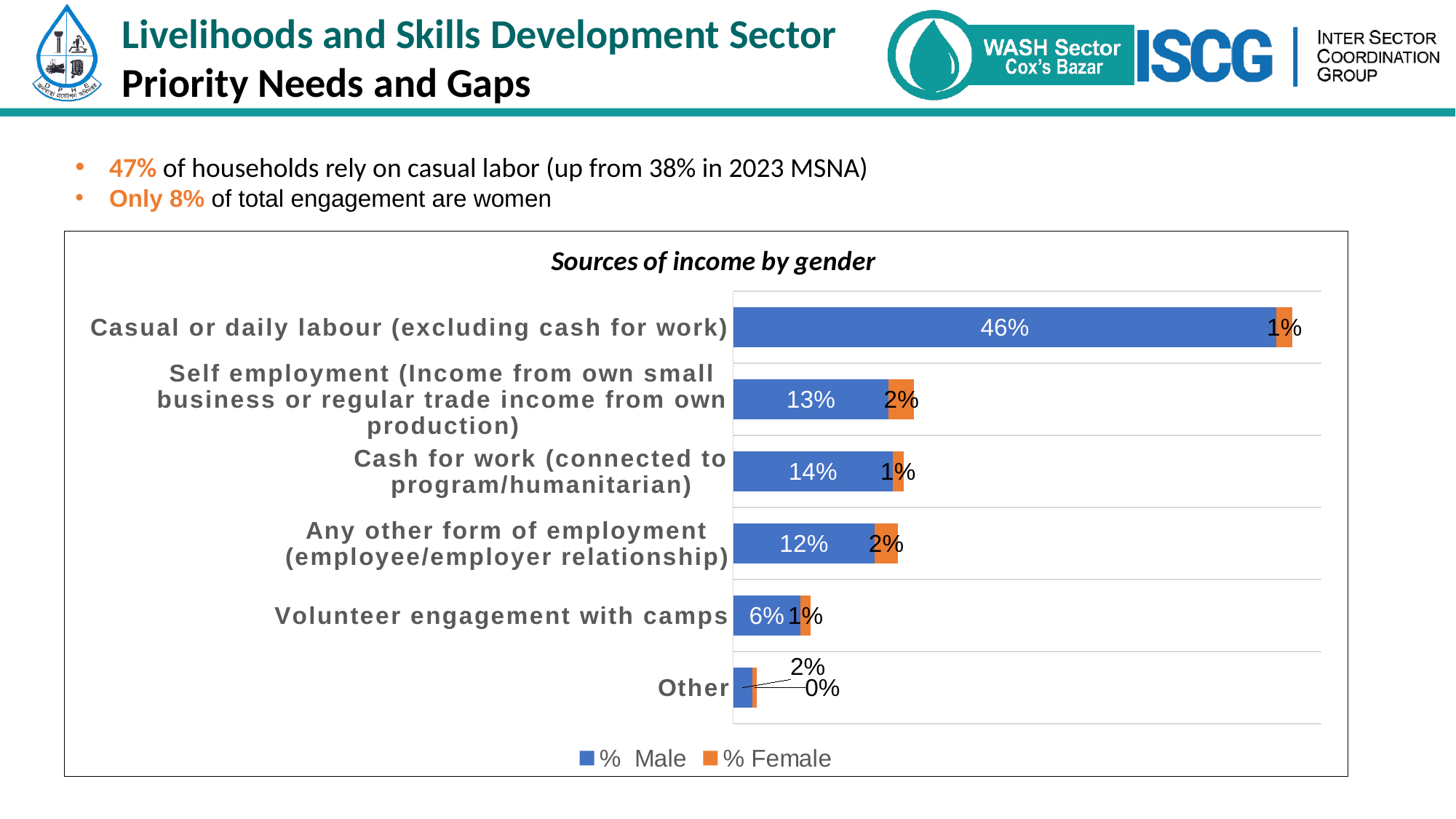
What is the % Male value for Casual or daily labour (excluding cash for work)? 46% Which is larger: the % Male value for Cash for work (connected to program/humanitarian) or for Any other form of employment (employee/employer relationship)? Cash for work (connected to program/humanitarian) What is the % Male value for Cash for work (connected to program/humanitarian)? 14% What is the combined total of % Male and % Female for Volunteer engagement with camps? 7% How many income source categories are shown in the chart? 6 What type of chart is shown on the slide? Stacked bar chart Which category has the lowest % Male value? Other What is the title of the chart? Sources of income by gender What is the % Female value for Self employment (Income from own small business or regular trade income from own production)? 2% What is the difference between the % Male values for Casual or daily labour (excluding cash for work) and Cash for work (connected to program/humanitarian)? 32% Which category has the highest % Male value? Casual or daily labour (excluding cash for work) How many series does the chart legend list? 2